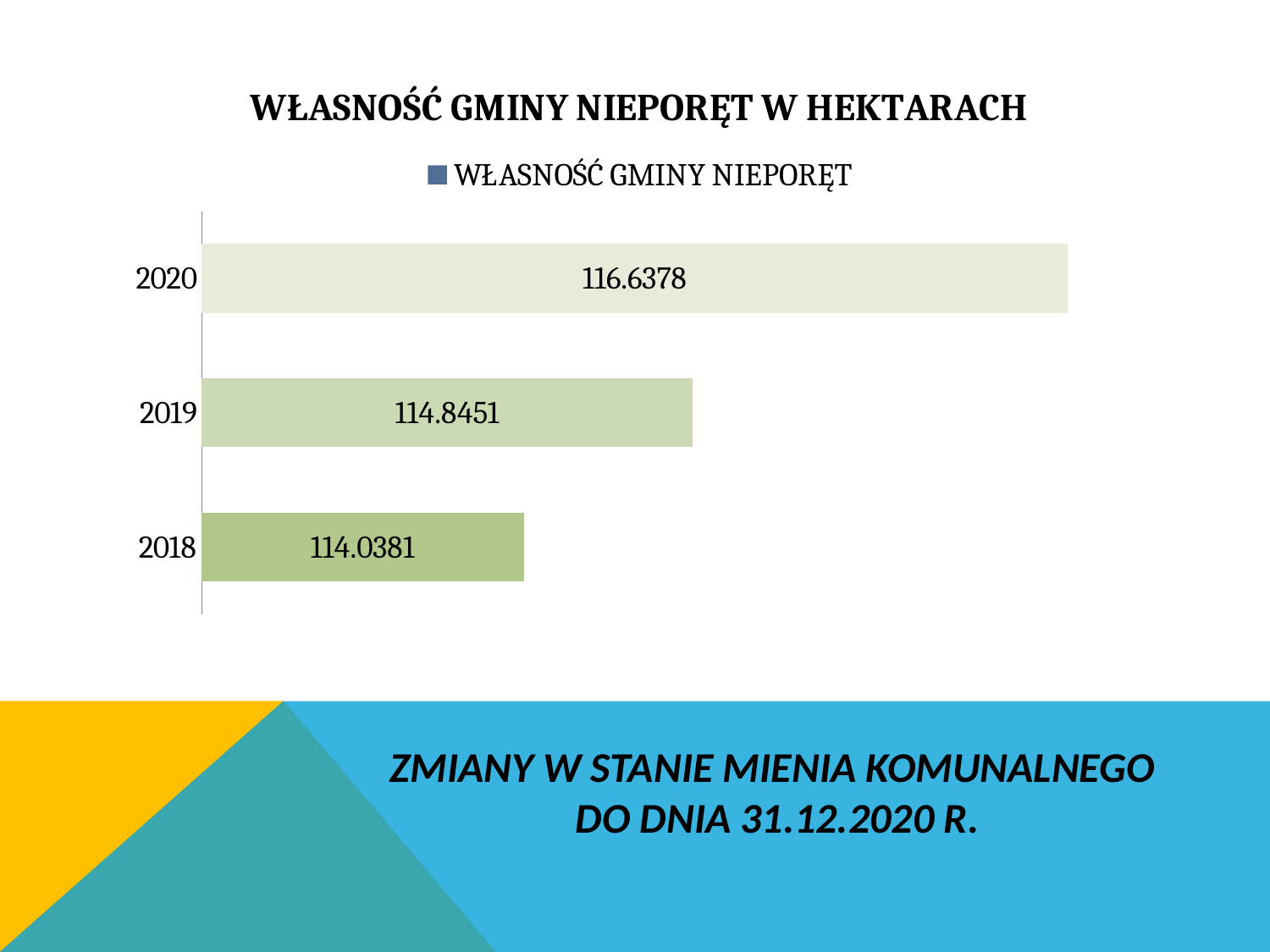
Which year has the highest value? 2020 What is the value for 2020? 116.6378 What kind of chart is shown on the slide? bar chart What is the value for 2019? 114.8451 Which year has the lowest value? 2018 What is the value for 2018? 114.0381 What is the difference between the values for 2019 and 2018? 0.8070 How many years are shown in the chart? 3 Do the values rise or fall from 2018 to 2020? rise How many series does the legend list? 1 Which is larger, the value for 2019 or the value for 2018? 2019 What is the difference between the values for 2020 and 2019? 1.7927